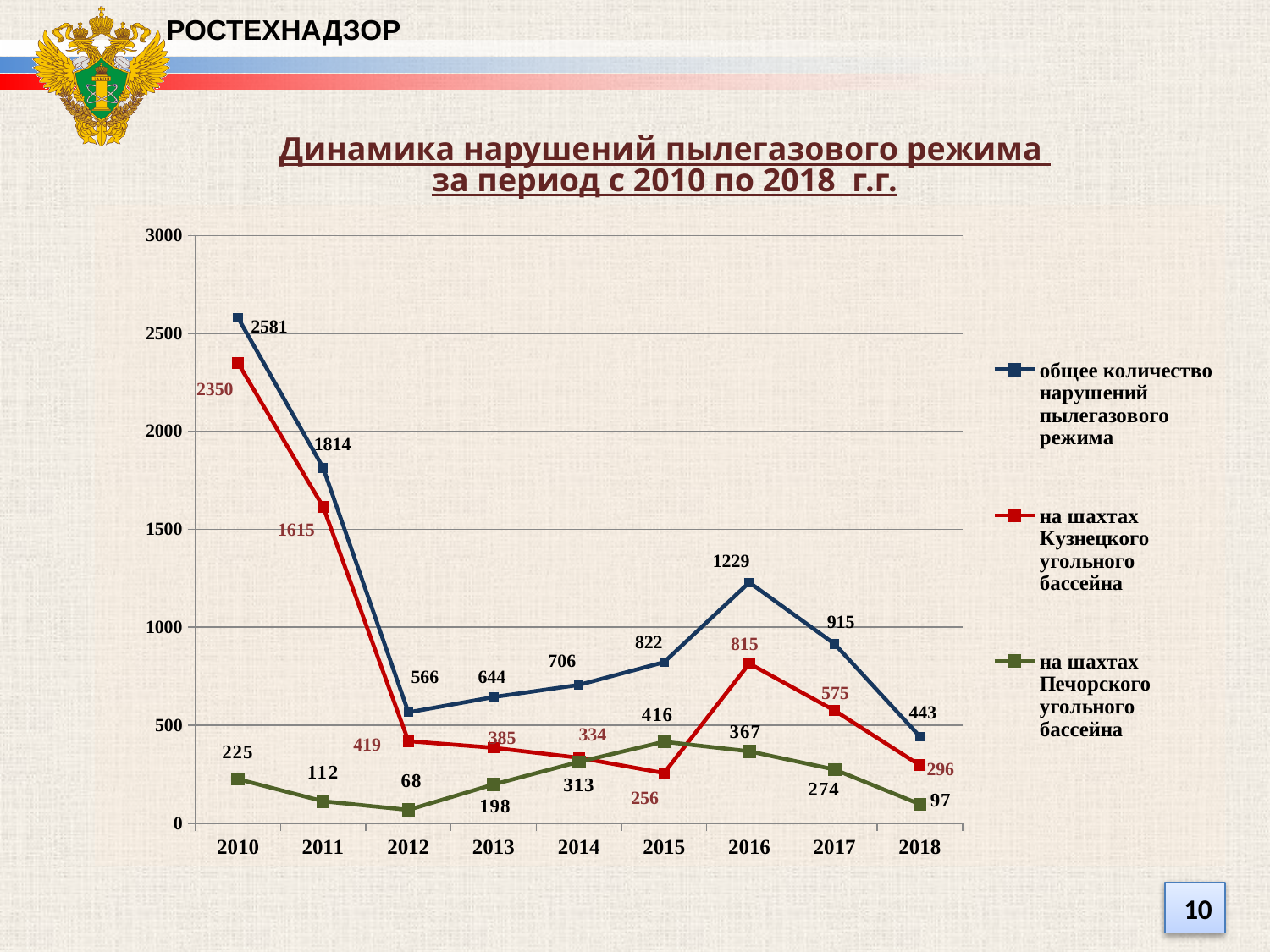
What is the difference between the total number of violations in 2010 and in 2018? 2138 What colour is the line for the Kuznetsk coal basin mines? red How many years are plotted along the x axis? 9 How many series does the legend list? 3 In 2015, which is larger: the value for the Kuznetsk basin mines or the Pechora basin mines? Pechora basin mines (на шахтах Печорского угольного бассейна) What is the total number of dust-gas regime violations (общее количество нарушений) in 2016? 1229 Does the total number of violations rise or fall from 2010 to 2012? fall In which year is the value for the Pechora coal basin mines the lowest? 2012 What type of chart is shown on the slide? line chart What is the value for the Pechora coal basin mines (на шахтах Печорского угольного бассейна) in 2015? 416 In which year is the total number of violations the highest? 2010 What is the value for the Kuznetsk coal basin mines (на шахтах Кузнецкого угольного бассейна) in 2012? 419